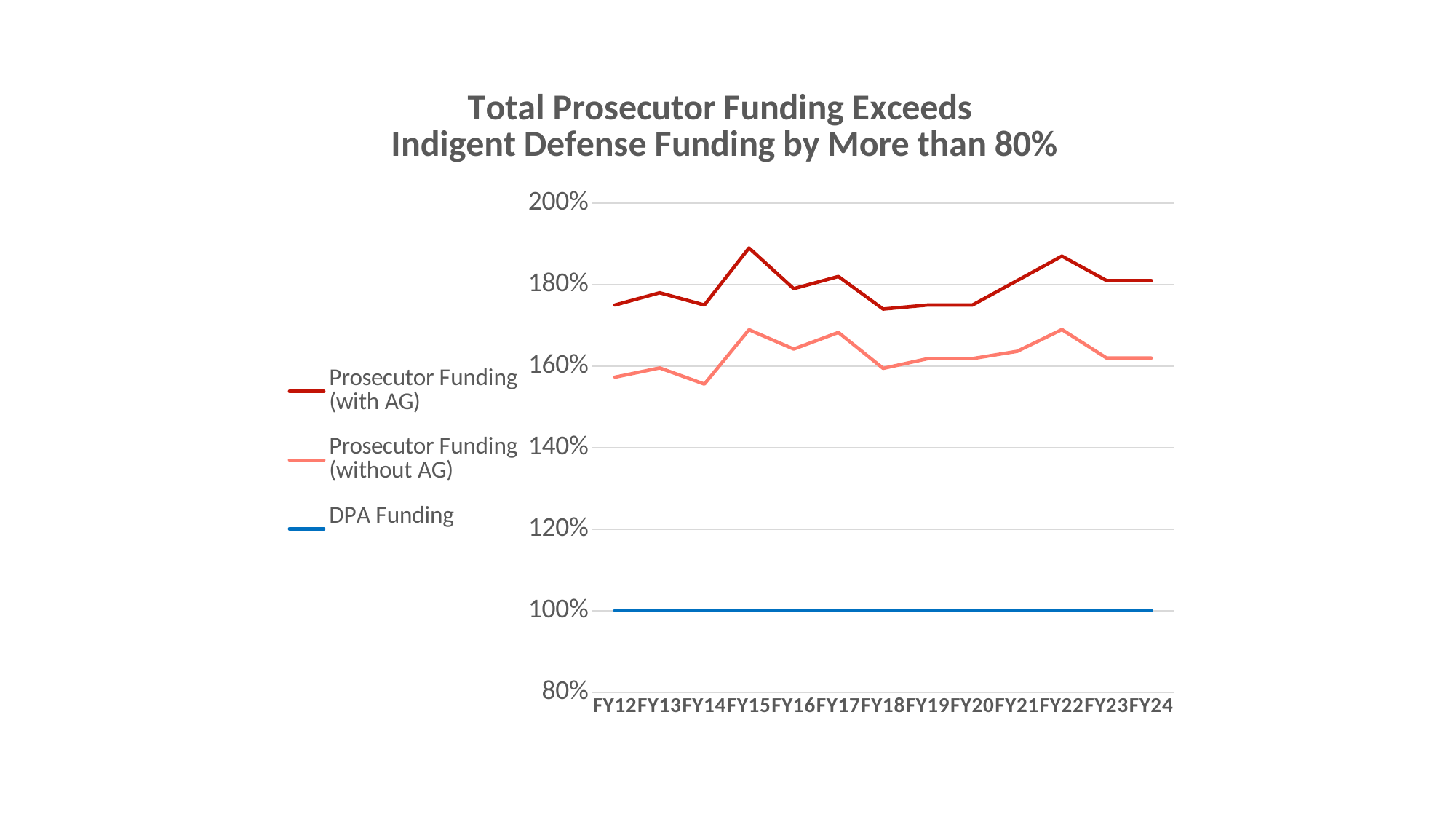
Is the value for Prosecutor Funding (without AG) in FY22 greater or less than 160%? greater Is the value for Prosecutor Funding (without AG) in FY14 greater or less than 160%? less Is the value for Prosecutor Funding (with AG) in FY15 greater or less than 180%? greater In FY15, which is larger: Prosecutor Funding (with AG) or Prosecutor Funding (without AG)? Prosecutor Funding (with AG) What kind of chart is shown on the slide? line chart What is the value of DPA Funding in FY12? 100% Does the DPA Funding line rise, fall, or stay flat from FY12 to FY24? stays flat What is the title of the chart? Total Prosecutor Funding Exceeds Indigent Defense Funding by More than 80% How many series does the legend list? 3 In which fiscal year does Prosecutor Funding (with AG) reach its highest value? FY15 How many fiscal years are plotted along the x axis? 13